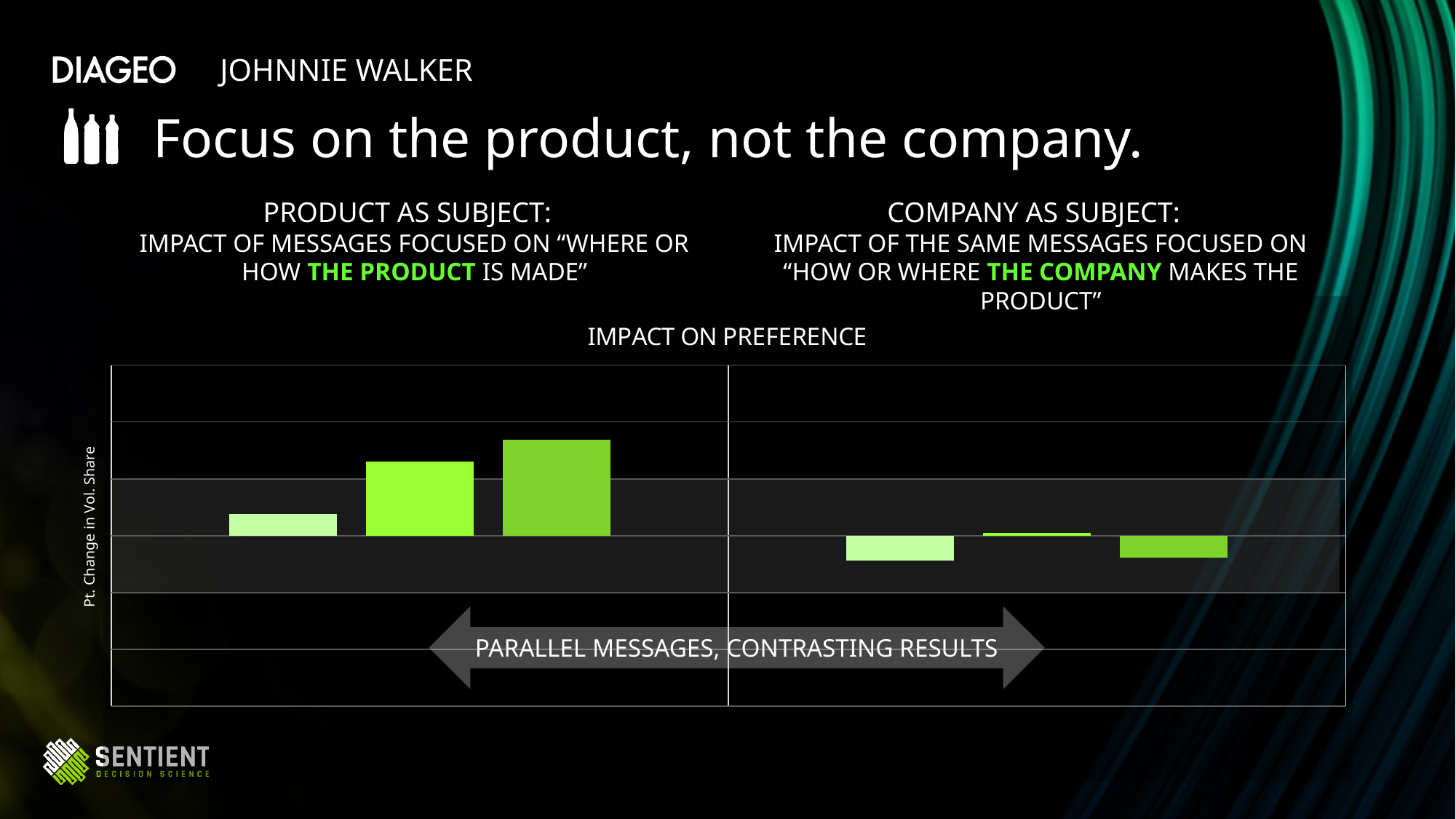
How many bars are plotted in the chart in total? 6 Which is larger: the first bar on the "Product as Subject" side or the first bar on the "Company as Subject" side? the first bar on the Product as Subject side What is the label on the vertical axis of the chart? Pt. Change in Vol. Share On the "Product as Subject" side, which bar is the highest: the first, second or third? third How many bars are plotted on the "Company as Subject" side of the chart? 3 What kind of chart is shown on the slide? bar chart How many bars are plotted on the "Product as Subject" side of the chart? 3 Which is larger: the second bar on the "Product as Subject" side or the first bar on the "Product as Subject" side? the second bar What is the title of the chart? IMPACT ON PREFERENCE Which is larger: the third bar on the "Product as Subject" side or the second bar on the "Company as Subject" side? the third bar on the Product as Subject side On the "Product as Subject" side, do the bar values rise or fall from left to right? rise Which side of the chart contains the tallest bar, "Product as Subject" or "Company as Subject"? Product as Subject